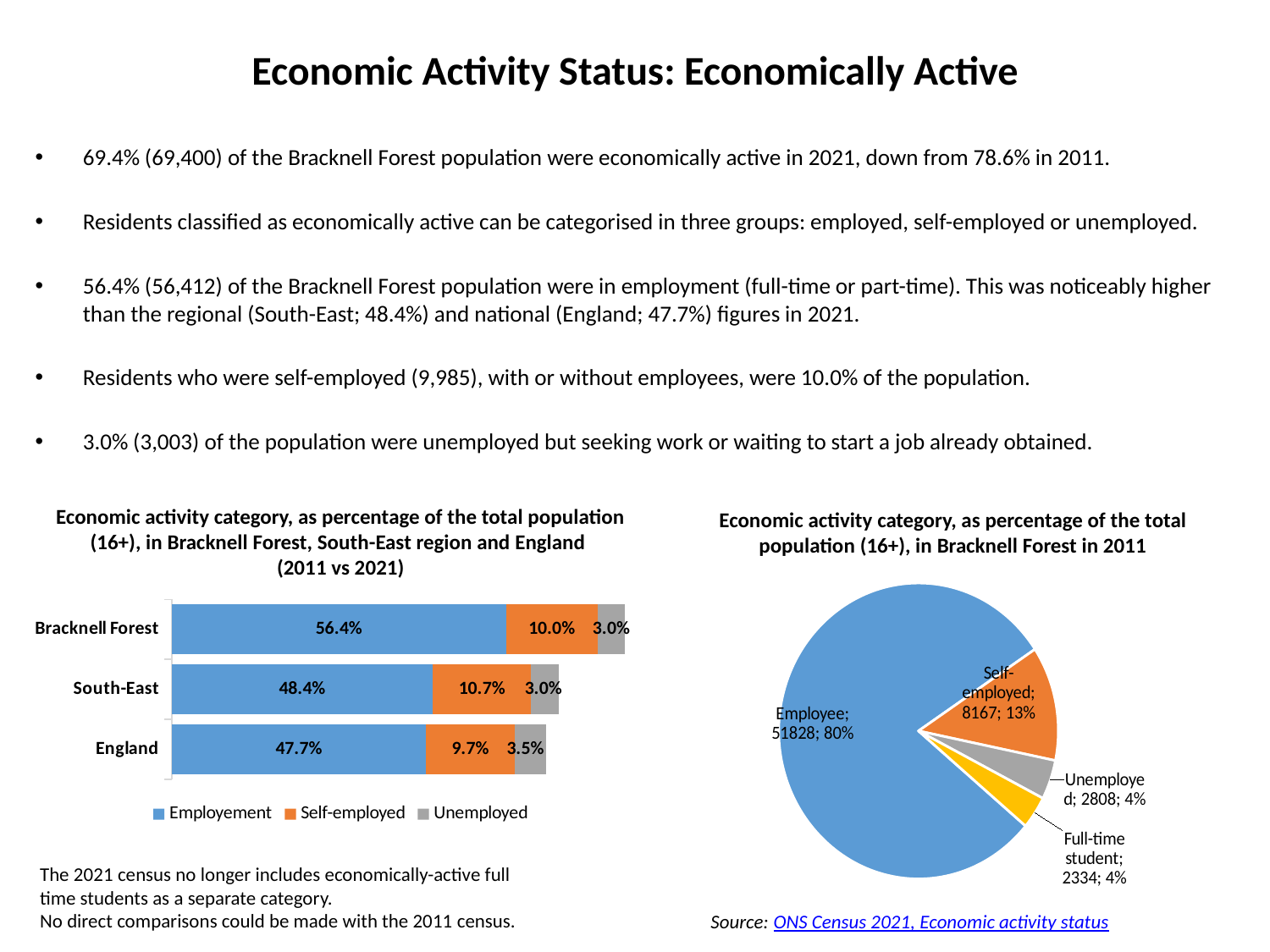
In the bar chart on the left, what is the difference between the Employement values for Bracknell Forest and England? 8.7% In the bar chart on the left, which area has the highest Employement value? Bracknell Forest In the bar chart on the left, what is the total of the stacked bar for Bracknell Forest? 69.4% In the bar chart on the left, what is the Employement value for Bracknell Forest? 56.4% In the pie chart on the right, which category has the largest slice? Employee How many series does the legend of the bar chart on the left list? 3 In the pie chart on the right, what share of the pie is the Self-employed slice? 13% In the bar chart on the left, what is the Self-employed value for South-East? 10.7% In the bar chart on the left, what is the Unemployed value for England? 3.5% In the pie chart on the right, what is the value shown for Full-time student? 2334 What kind of chart is the chart on the left of the slide? Stacked bar chart In the bar chart on the left, which area has the lowest Self-employed value? England